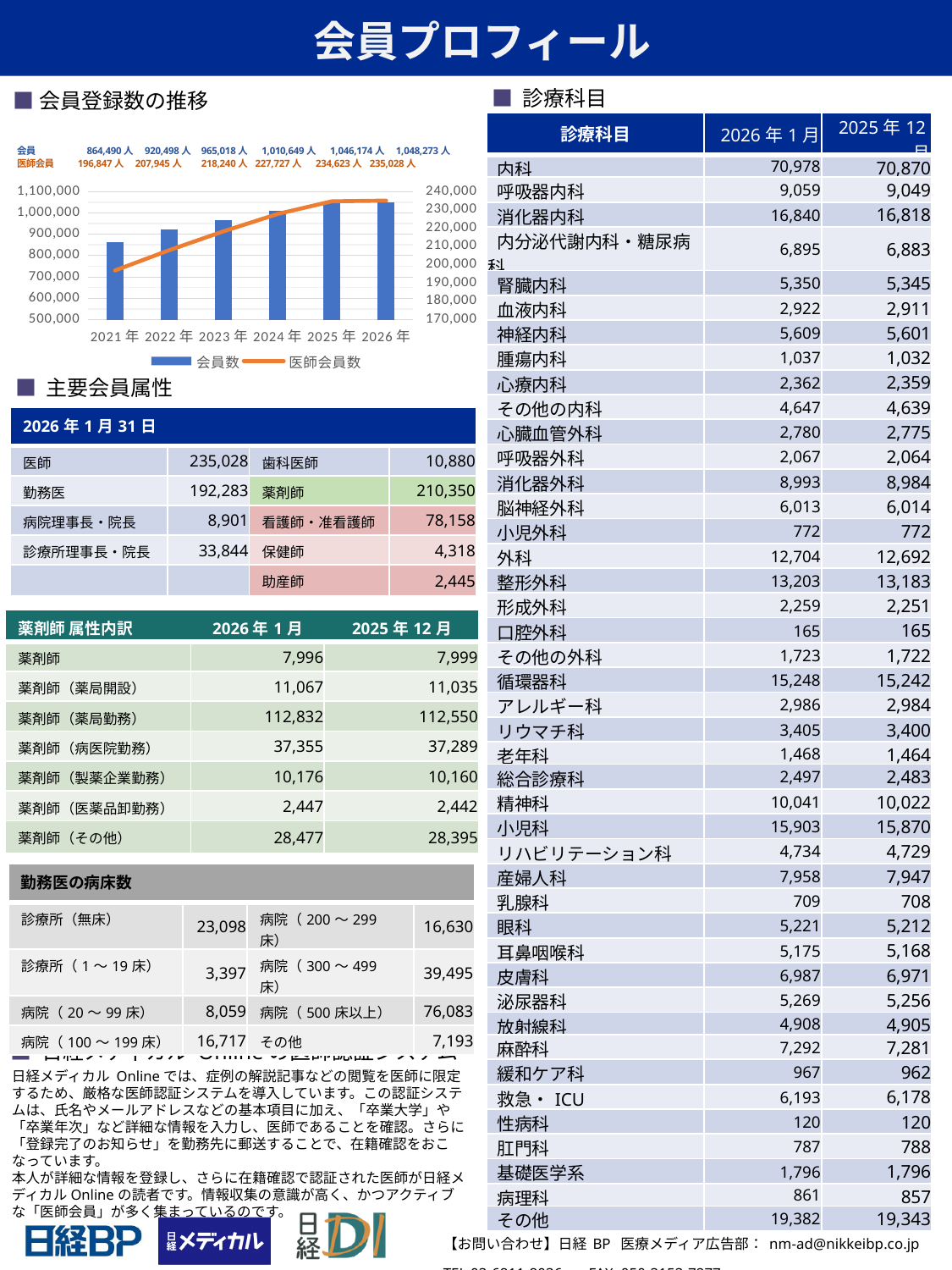
In the 会員登録数の推移 chart, what is the 医師会員 value for 2026年? 235,028人 In the 会員登録数の推移 chart, which year has the lowest 医師会員 value? 2021年 In the 会員登録数の推移 chart, which year has the highest 会員 value? 2026年 In the 会員登録数の推移 chart, what is the difference between the 会員 values for 2026年 and 2021年? 183,783人 In the 会員登録数の推移 chart, what is the 医師会員 value for 2023年? 218,240人 In the 会員登録数の推移 chart, what is the 会員 value for 2021年? 864,490人 How many series does the legend of the 会員登録数の推移 chart list? 2 In the 会員登録数の推移 chart, what is the difference between the 医師会員 values for 2026年 and 2025年? 405人 In the 会員登録数の推移 chart, do the 会員数 values rise or fall from 2021年 to 2026年? rise In the 会員登録数の推移 chart, what is the 会員 value for 2024年? 1,010,649人 In the 会員登録数の推移 chart, is the 会員 value for 2023年 greater or less than 1,000,000? less How many years are shown on the x axis of the 会員登録数の推移 chart? 6